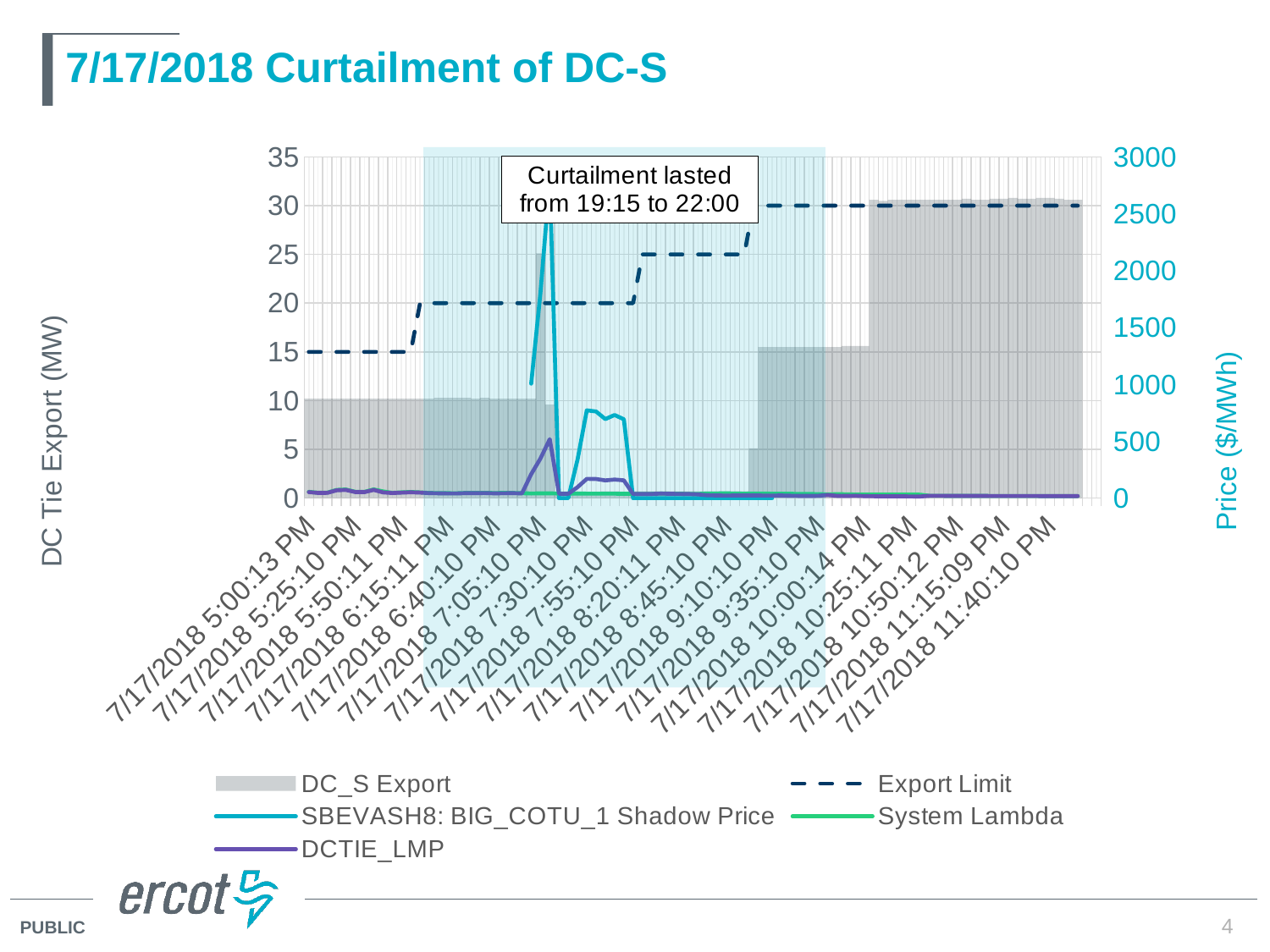
What is the highest value the Export Limit series reaches? 30 By how much does the Export Limit at 7/17/2018 10:25:11 PM exceed the Export Limit at 7/17/2018 5:00:13 PM? 15 Is the DC_S Export value at 7/17/2018 11:15:09 PM greater or less than 25? greater What is the lowest value the Export Limit series shows? 15 What is the Export Limit value at 7/17/2018 7:05:10 PM? 20 Which is larger, the DC_S Export at 7/17/2018 11:15:09 PM or at 7/17/2018 5:00:13 PM? 7/17/2018 11:15:09 PM What is the Export Limit value at 7/17/2018 10:25:11 PM? 30 According to the annotation on the chart, when did the curtailment last from and to? from 19:15 to 22:00 How many series does the legend list? 5 What is the Export Limit value at 7/17/2018 5:00:13 PM? 15 Does the Export Limit series rise or fall along the x axis? rise Is the DC_S Export value at 7/17/2018 5:00:13 PM greater or less than 15? less